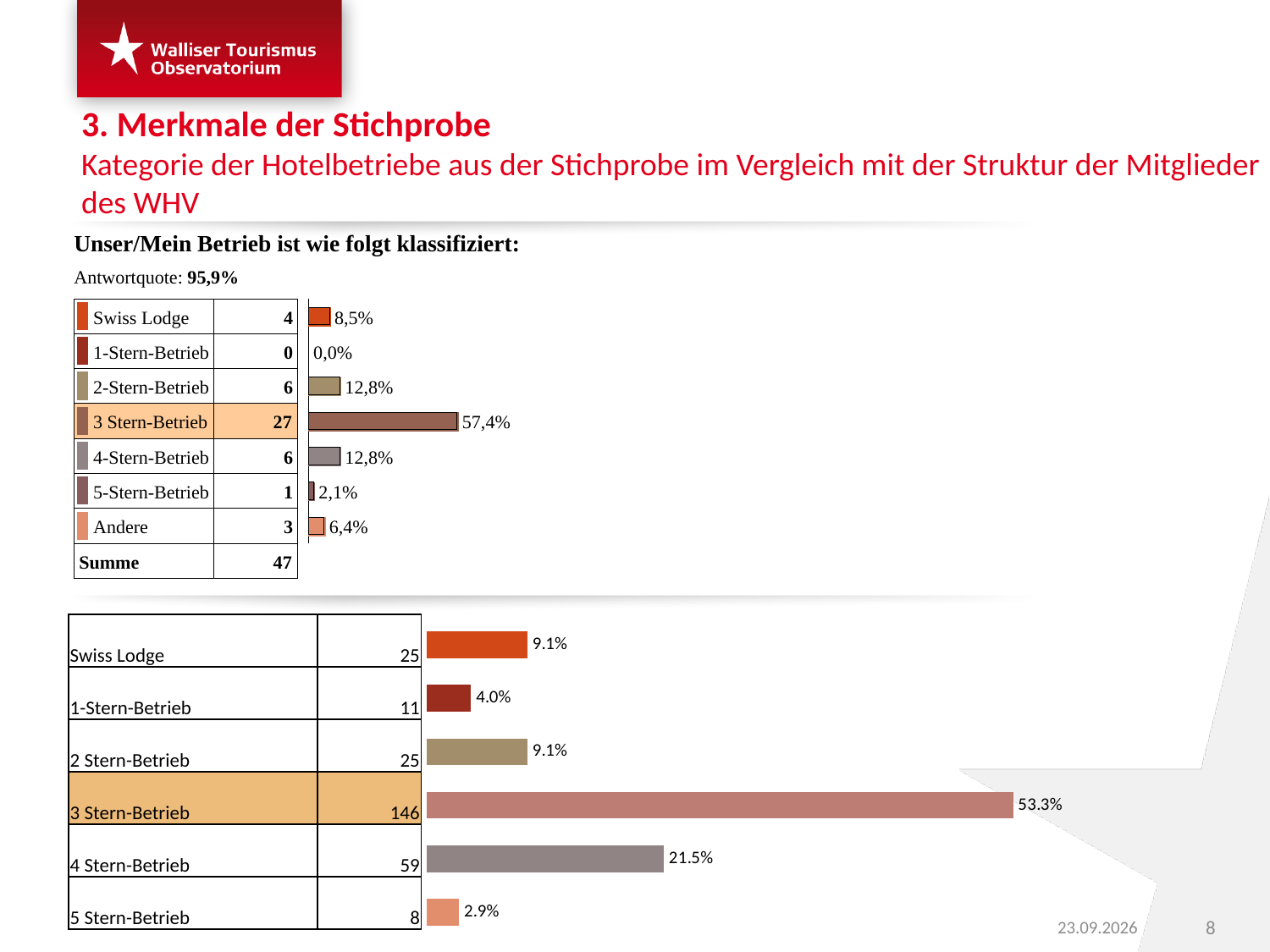
In the lower chart, what percentage is shown for 4 Stern-Betrieb? 21.5% In the upper chart, what percentage is shown for Swiss Lodge? 8,5% What type of chart is the lower chart? Bar chart In the lower chart, how many categories are plotted? 6 In the upper chart, how many categories are plotted? 7 In the upper chart, what is the difference in percentage points between 3 Stern-Betrieb and 2-Stern-Betrieb? 44,6 In the upper chart, which category has the lowest percentage? 1-Stern-Betrieb In the lower chart, what percentage is shown for 3 Stern-Betrieb? 53.3% In the lower chart, which category has the lowest percentage? 5 Stern-Betrieb In the upper chart, what percentage is shown for 3 Stern-Betrieb? 57,4% In the upper chart, which category has the highest percentage? 3 Stern-Betrieb In the lower chart, which is larger: the value for 1-Stern-Betrieb or the value for 5 Stern-Betrieb? 1-Stern-Betrieb